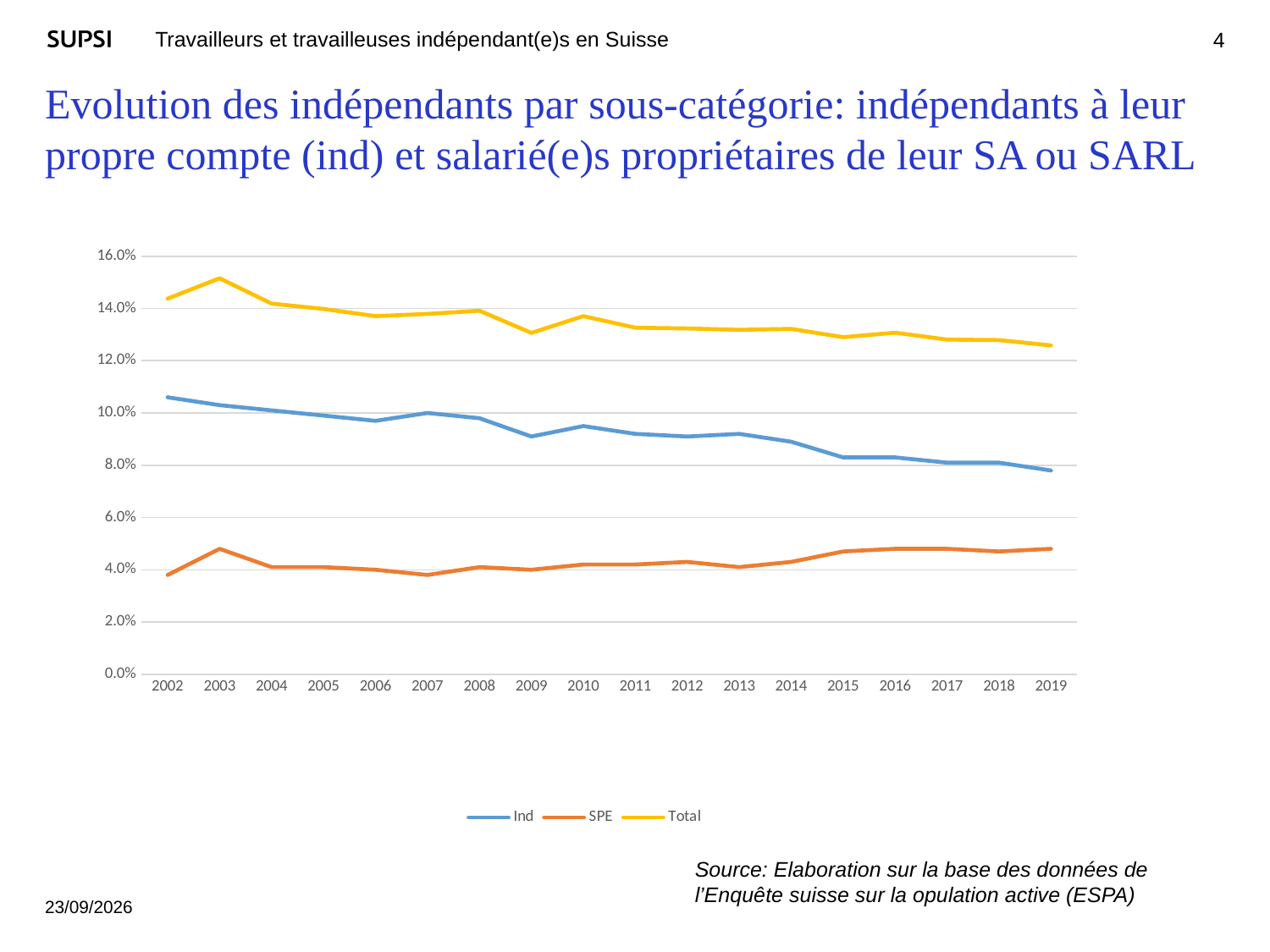
Which colour is used for the Total series in the legend? yellow How many years are plotted along the x axis? 18 Does the Total series rise or fall overall from 2002 to 2019? fall In which year is the Ind series at its highest? 2002 Which series has the larger value in 2010, Ind or SPE? Ind Does the Ind series rise or fall overall from 2002 to 2019? fall In which year is the Ind series at its lowest? 2019 In which year is the Total series at its highest? 2003 What kind of chart is shown on the slide? line chart Is the value for Ind in 2002 greater or less than 10.0%? greater How many series does the legend list? 3 Is the value for Total in 2009 greater or less than 14.0%? less